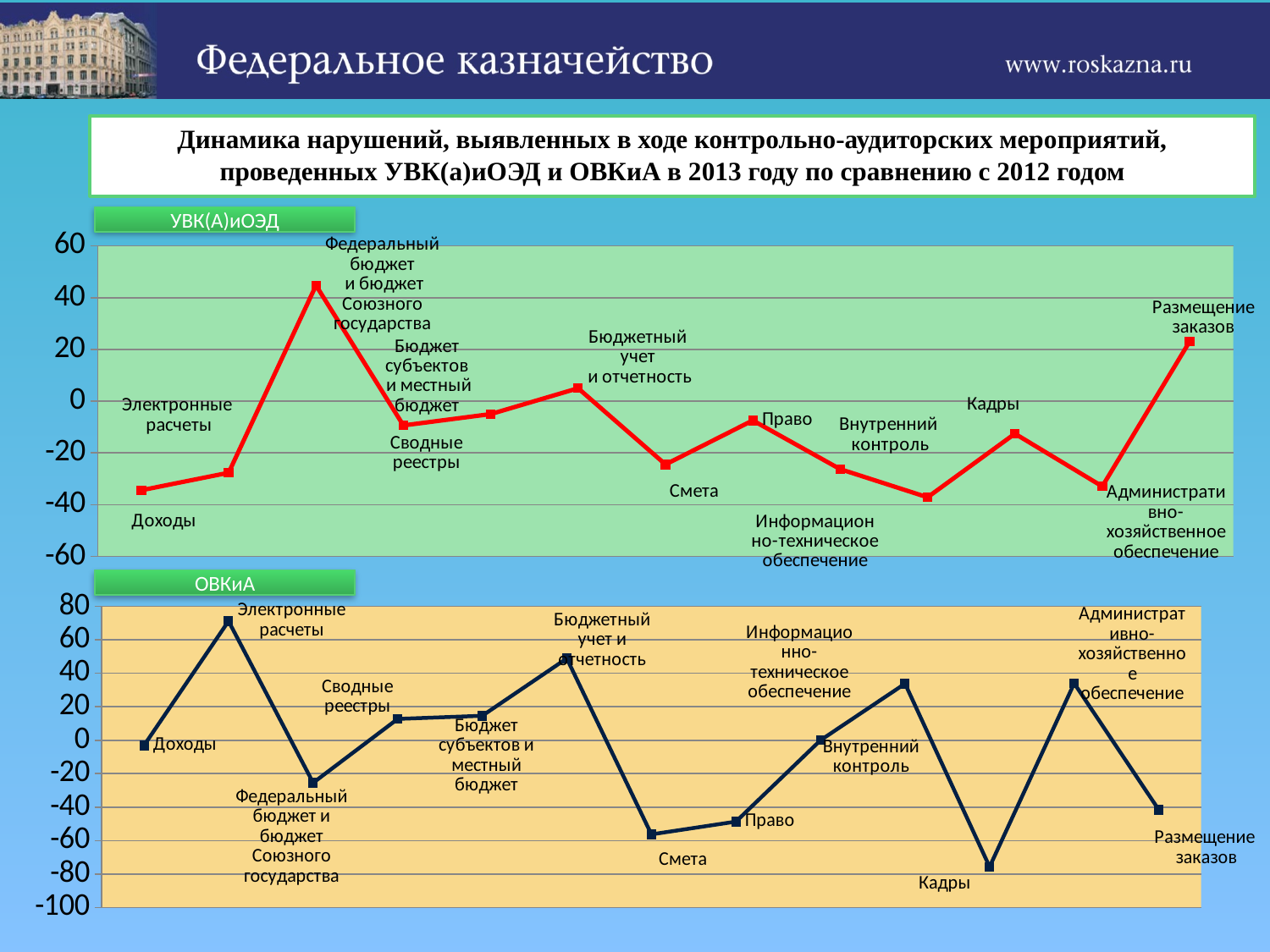
What kind of chart is the top chart titled УВК(А)иОЭД? line chart What colour is the line in the top chart (УВК(А)иОЭД)? red In the top chart (УВК(А)иОЭД), is the value for Доходы greater or less than -20? less In the top chart (УВК(А)иОЭД), which category has the highest value? Федеральный бюджет и бюджет Союзного государства In the bottom chart (ОВКиА), which category has the highest value? Электронные расчеты What kind of chart is the bottom chart titled ОВКиА? line chart In the top chart (УВК(А)иОЭД), which is larger: the value for Бюджетный учет и отчетность or the value for Смета? Бюджетный учет и отчетность In the top chart (УВК(А)иОЭД), is the value for Размещение заказов greater or less than 20? greater In the bottom chart (ОВКиА), which category has the lowest value? Кадры How many data points are plotted in the bottom chart (ОВКиА)? 13 In the bottom chart (ОВКиА), is the value for Бюджетный учет и отчетность greater or less than 40? greater